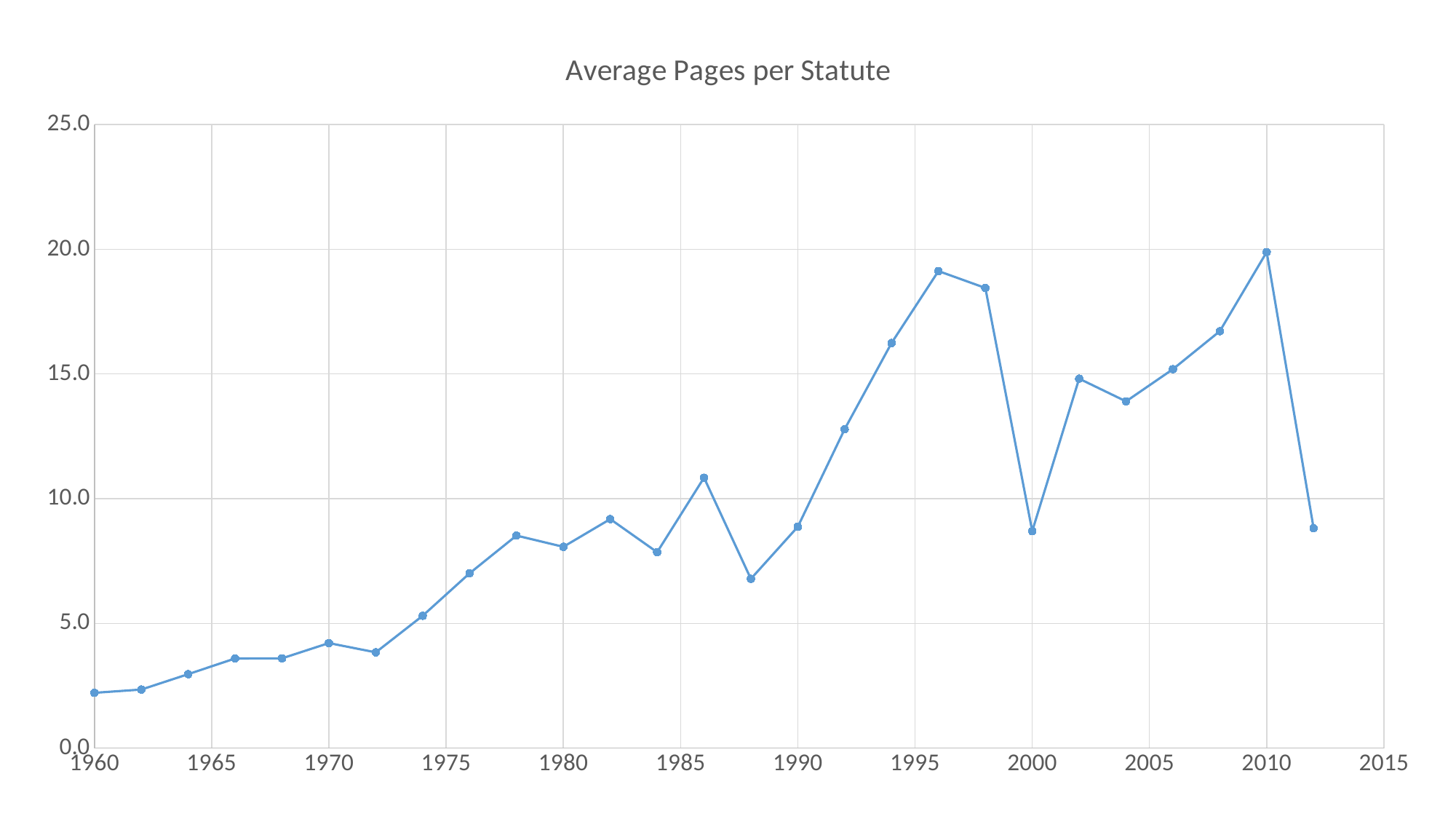
Is the value for 1986 greater or less than 10.0? greater What is the title of the chart? Average Pages per Statute In which year is the average pages per statute highest? 2010 Does the value rise or fall from 2010 to 2012? fall What type of chart is shown on the slide? line chart Which year has the larger value, 2000 or 2002? 2002 How many data points are plotted on the line? 27 Is the value for 2012 greater or less than 10.0? less Which year has the larger value, 1986 or 1988? 1986 Is the value for 1996 greater or less than 15.0? greater